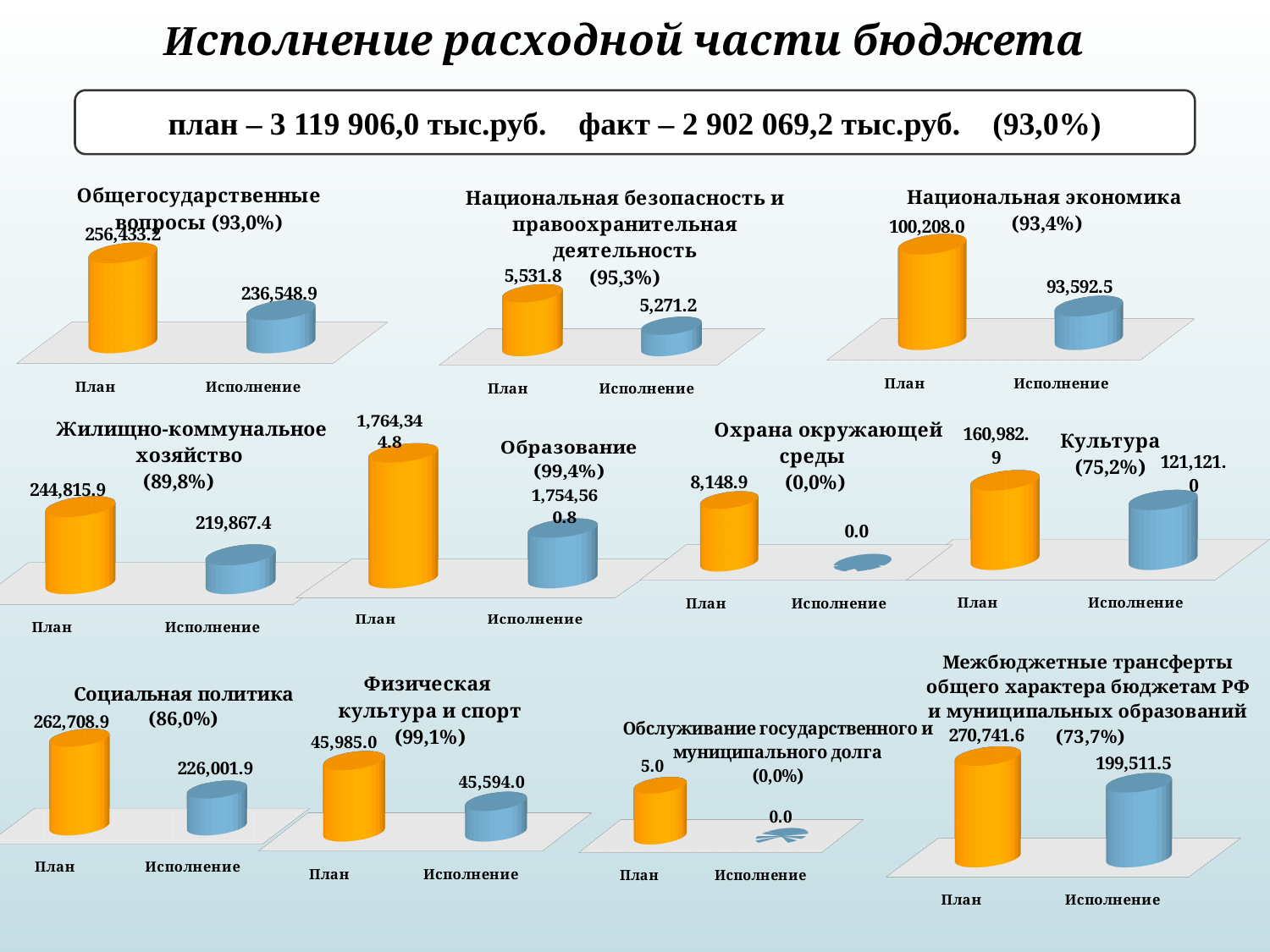
In the 'Физическая культура и спорт' chart, what is the difference between План and Исполнение? 391.0 In the 'Жилищно-коммунальное хозяйство' chart, which category has the lowest value? Исполнение What type of chart is used for 'Социальная политика'? Bar chart In the 'Национальная экономика' chart, what is the difference between План and Исполнение? 6,615.5 In the 'Межбюджетные трансферты' chart, which is larger, План or Исполнение? План In the 'Обслуживание государственного и муниципального долга' chart, what is the value for План? 5.0 How many bars are shown in the 'Образование' chart? 2 In the 'Национальная экономика' chart, what is the value for План? 100,208.0 In the 'Культура' chart, what is the value for План? 160,982.9 In the 'Национальная экономика' chart, what is the value for Исполнение? 93,592.5 In the 'Охрана окружающей среды' chart, what is the value for Исполнение? 0.0 In the 'Социальная политика' chart, what is the value for Исполнение? 226,001.9